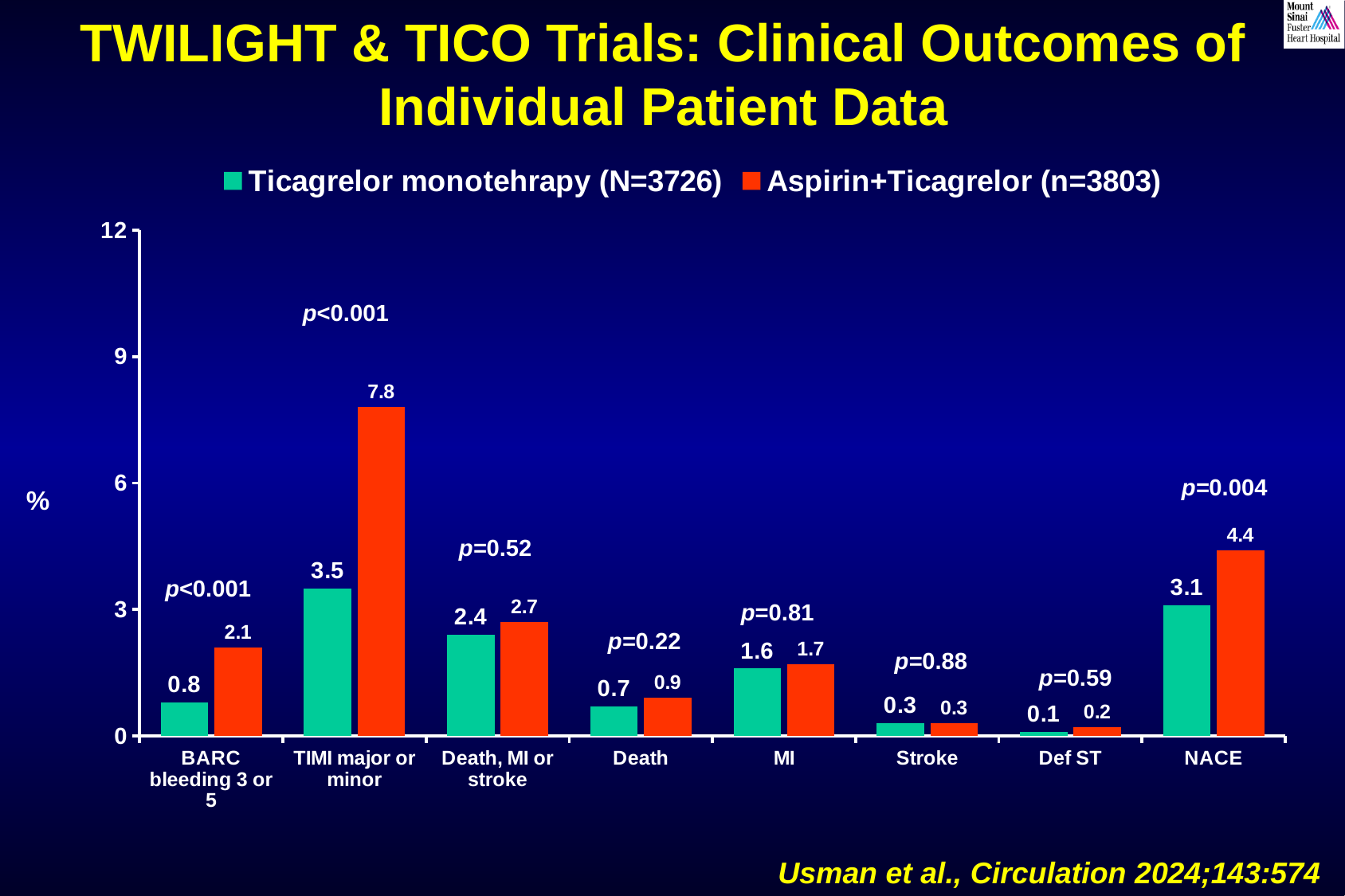
What is the value for Aspirin+Ticagrelor in the TIMI major or minor category? 7.8 What is the value for Ticagrelor monotehrapy in the NACE category? 3.1 What p-value is shown above the NACE category? p=0.004 How many outcome categories are shown on the x axis? 8 How many series does the legend list? 2 What is the difference between the Aspirin+Ticagrelor and Ticagrelor monotehrapy values in the NACE category? 1.3 What kind of chart is shown on the slide? Bar chart Which category has the highest value for Aspirin+Ticagrelor? TIMI major or minor Which is larger in the BARC bleeding 3 or 5 category: Ticagrelor monotehrapy or Aspirin+Ticagrelor? Aspirin+Ticagrelor Which category has the lowest value for Ticagrelor monotehrapy? Def ST What is the difference between the Aspirin+Ticagrelor and Ticagrelor monotehrapy values in the TIMI major or minor category? 4.3 What is the value for Ticagrelor monotehrapy in the BARC bleeding 3 or 5 category? 0.8